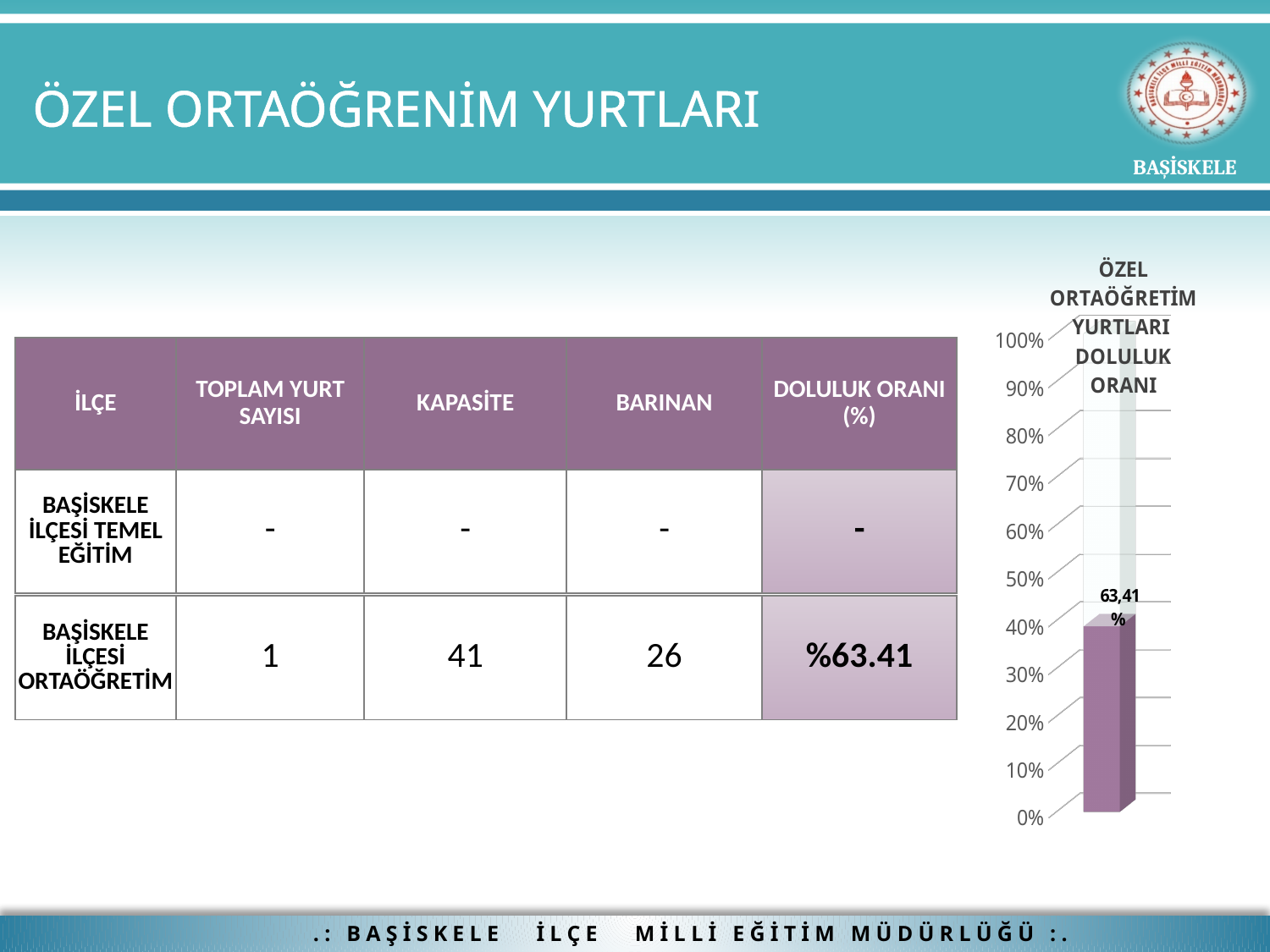
What value is printed on the bar in the chart titled ÖZEL ORTAÖĞRETİM YURTLARI DOLULUK ORANI? 63,41 % What is the highest tick value shown on the chart's vertical axis? 100% Is the value shown on the bar in the chart greater or less than 90%? less What kind of chart is shown on the right side of the slide? bar chart What is the title of the chart on the slide? ÖZEL ORTAÖĞRETİM YURTLARI DOLULUK ORANI Is the value shown on the bar in the chart greater or less than 10%? greater How many bars are plotted in the chart? 1